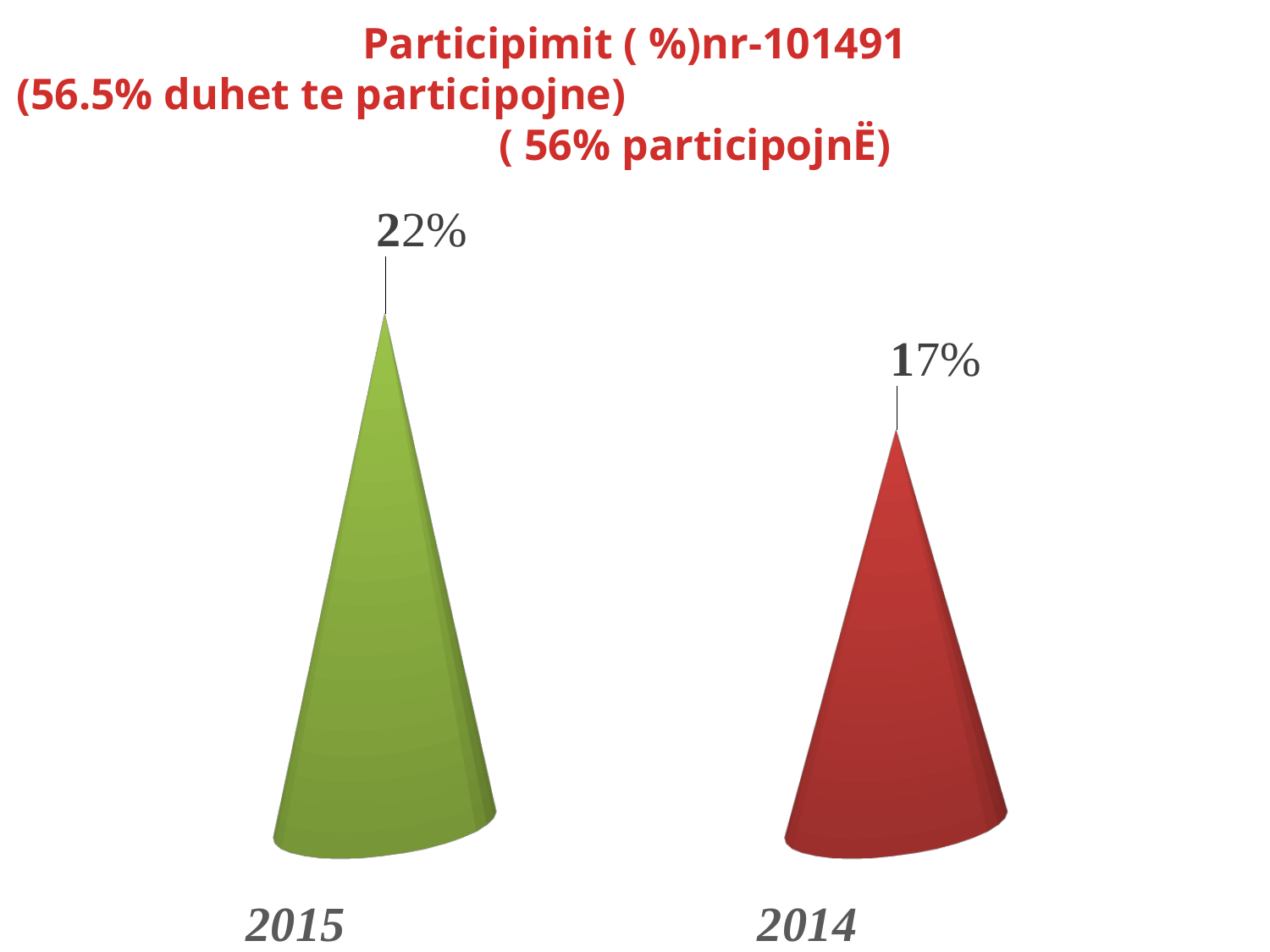
What is the difference between the values for 2015 and 2014? 5% What kind of chart is shown on the slide? bar chart Which is larger, the value for 2015 or the value for 2014? 2015 Which year has the lowest value? 2014 What colour is the bar for 2014? red What is the value for 2014? 17% How many categories are shown in the chart? 2 What is the value for 2015? 22% What colour is the bar for 2015? green Which year has the highest value? 2015